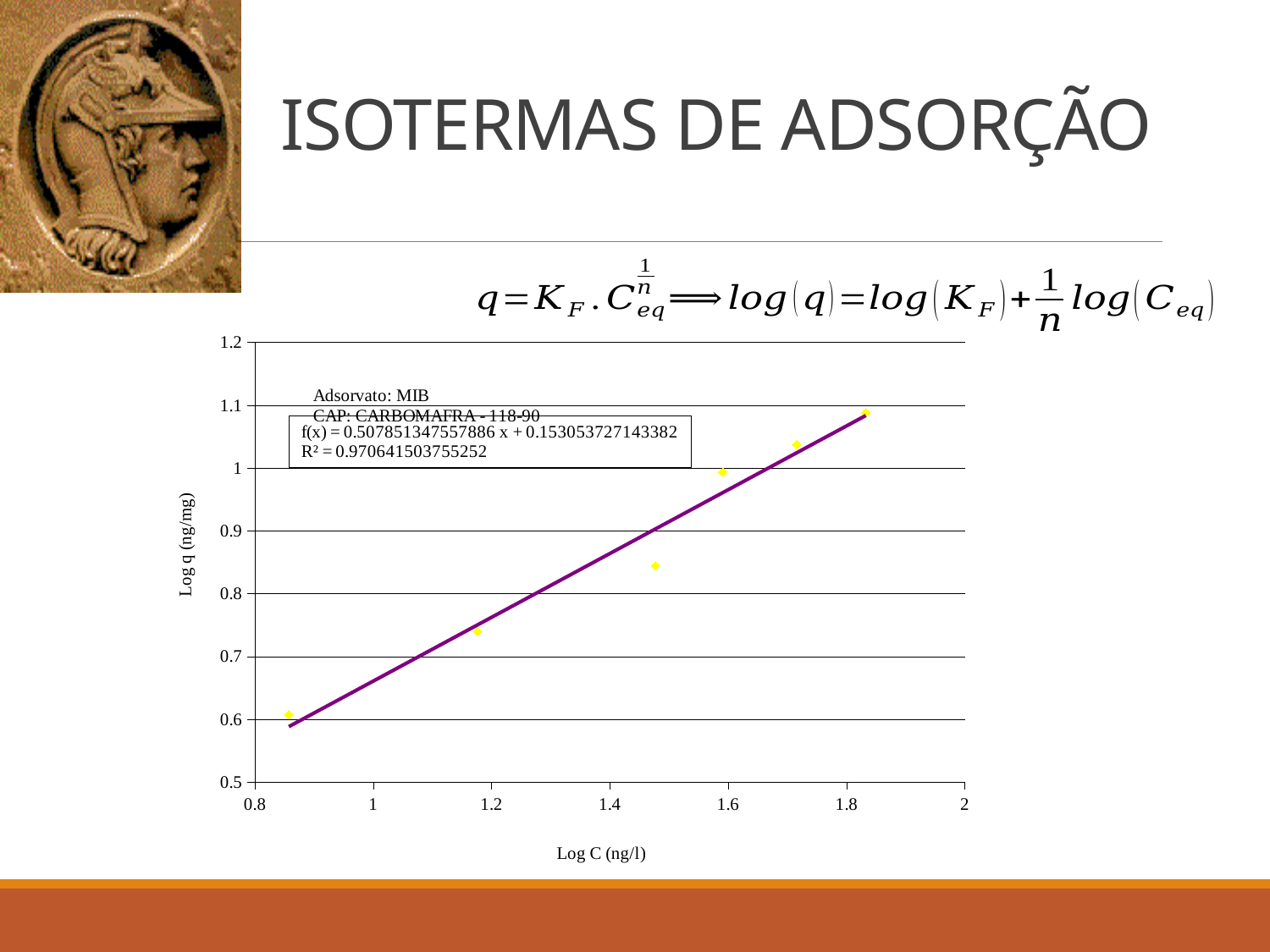
What is the slope of the fitted line f(x) printed on the chart? 0.507851347557886 Which data point has the highest Log q value, the leftmost or the rightmost? The rightmost Is the Log q value of the leftmost data point greater or less than 0.7? less Do the plotted values rise or fall as Log C increases along the x axis? Rise Is the Log q value of the rightmost data point greater or less than 1? greater What is the R² value printed on the chart? 0.970641503755252 What is the label of the y axis? Log q (ng/mg) How many data points are plotted on the chart? 6 What is the intercept of the fitted line f(x) printed on the chart? 0.153053727143382 Is the Log q value of the data point near Log C = 1.48 greater or less than 0.9? less What kind of chart is shown on the slide? Scatter chart What is the label of the x axis? Log C (ng/l)